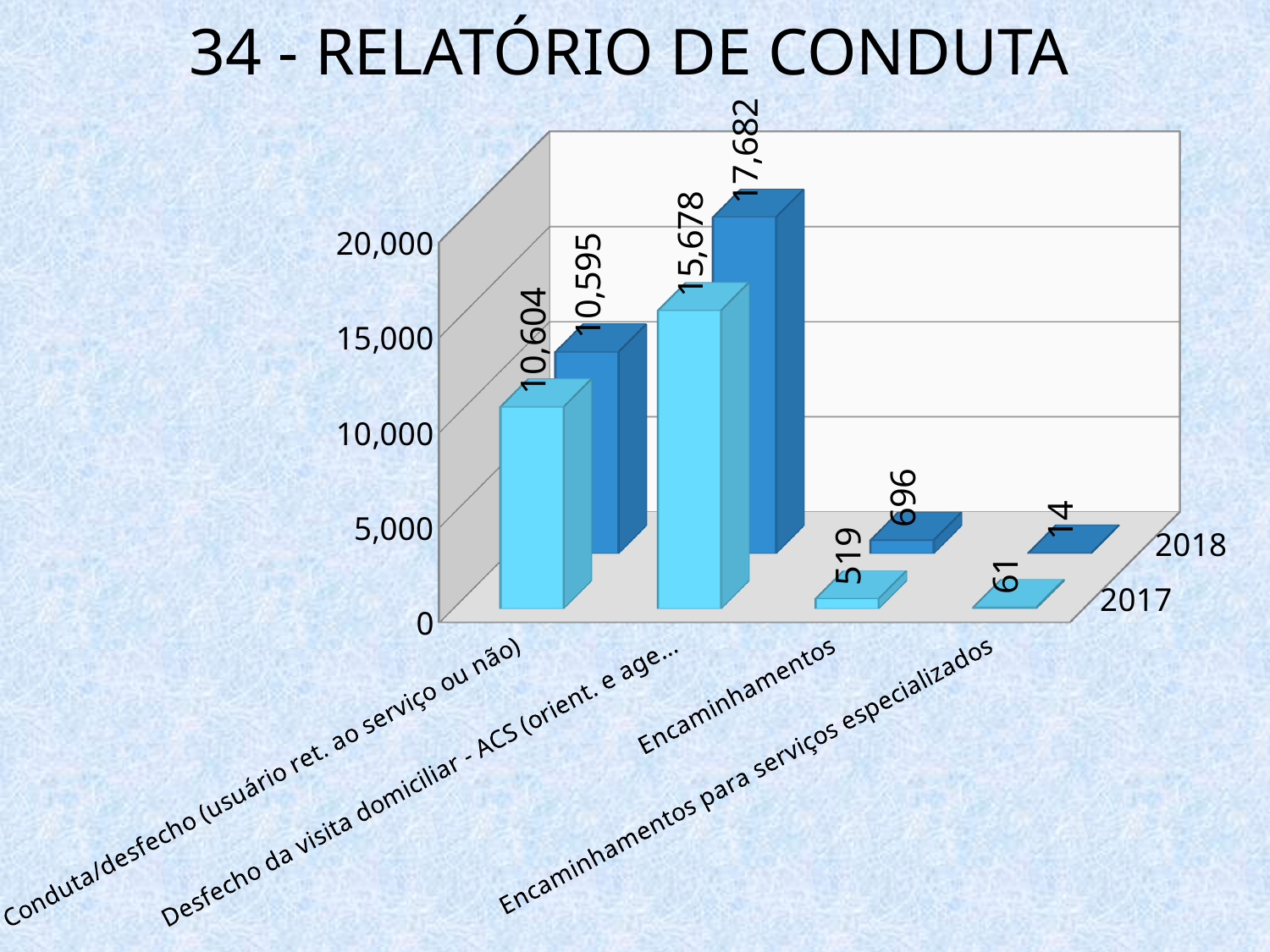
Which is larger for Encaminhamentos para serviços especializados, the 2017 value or the 2018 value? 2017 What is the 2017 value for Desfecho da visita domiciliar - ACS? 15,678 Which category has the lowest 2017 value? Encaminhamentos para serviços especializados What kind of chart is shown on the slide? bar chart What is the 2018 value for Encaminhamentos para serviços especializados? 14 What is the 2018 value for Encaminhamentos? 696 How many categories are shown on the x axis? 4 Which category has the highest 2018 value? Desfecho da visita domiciliar - ACS (orient. e age...) What is the 2017 value for Encaminhamentos? 519 What is the 2017 value for Conduta/desfecho (usuário ret. ao serviço ou não)? 10,604 What is the difference between the 2018 and 2017 values for Desfecho da visita domiciliar - ACS? 2,004 How many series does the chart show? 2